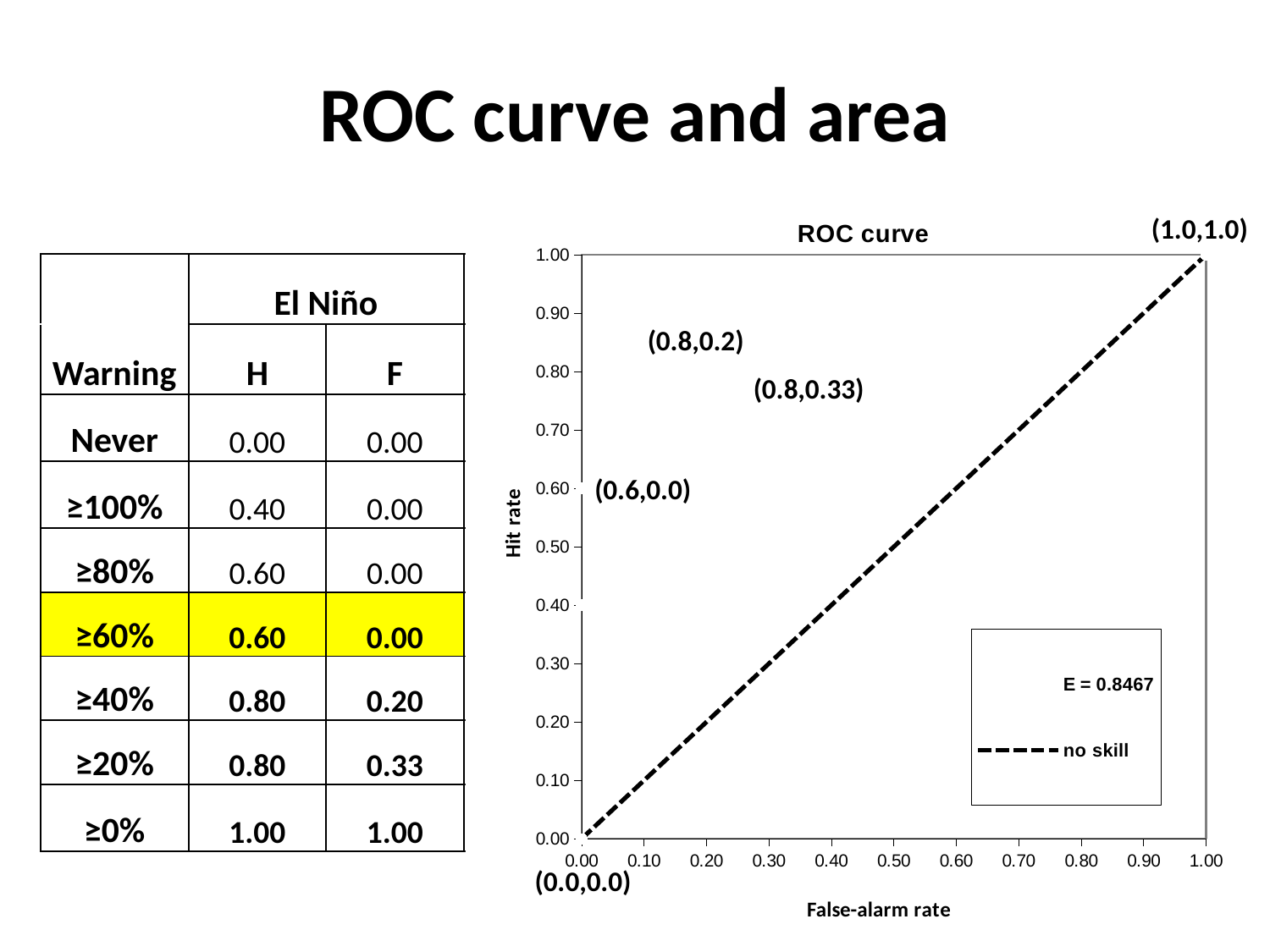
What is the name of the dashed line series in the chart's legend? no skill What coordinate label is printed at the top-right end of the 'no skill' line? (1.0,1.0) What is the label of the y axis of the chart? Hit rate How many entries does the chart's legend list? 2 What kind of chart is shown on the slide? line chart What is the label of the x axis of the chart? False-alarm rate What coordinate label is printed at the bottom-left origin of the chart? (0.0,0.0) What value of E is shown in the chart's legend? E = 0.8467 What is the title of the chart? ROC curve Does the 'no skill' line rise or fall as the false-alarm rate increases? rise What is the highest tick value shown on the chart's y axis? 1.00 How many coordinate point labels are printed on the chart? 5